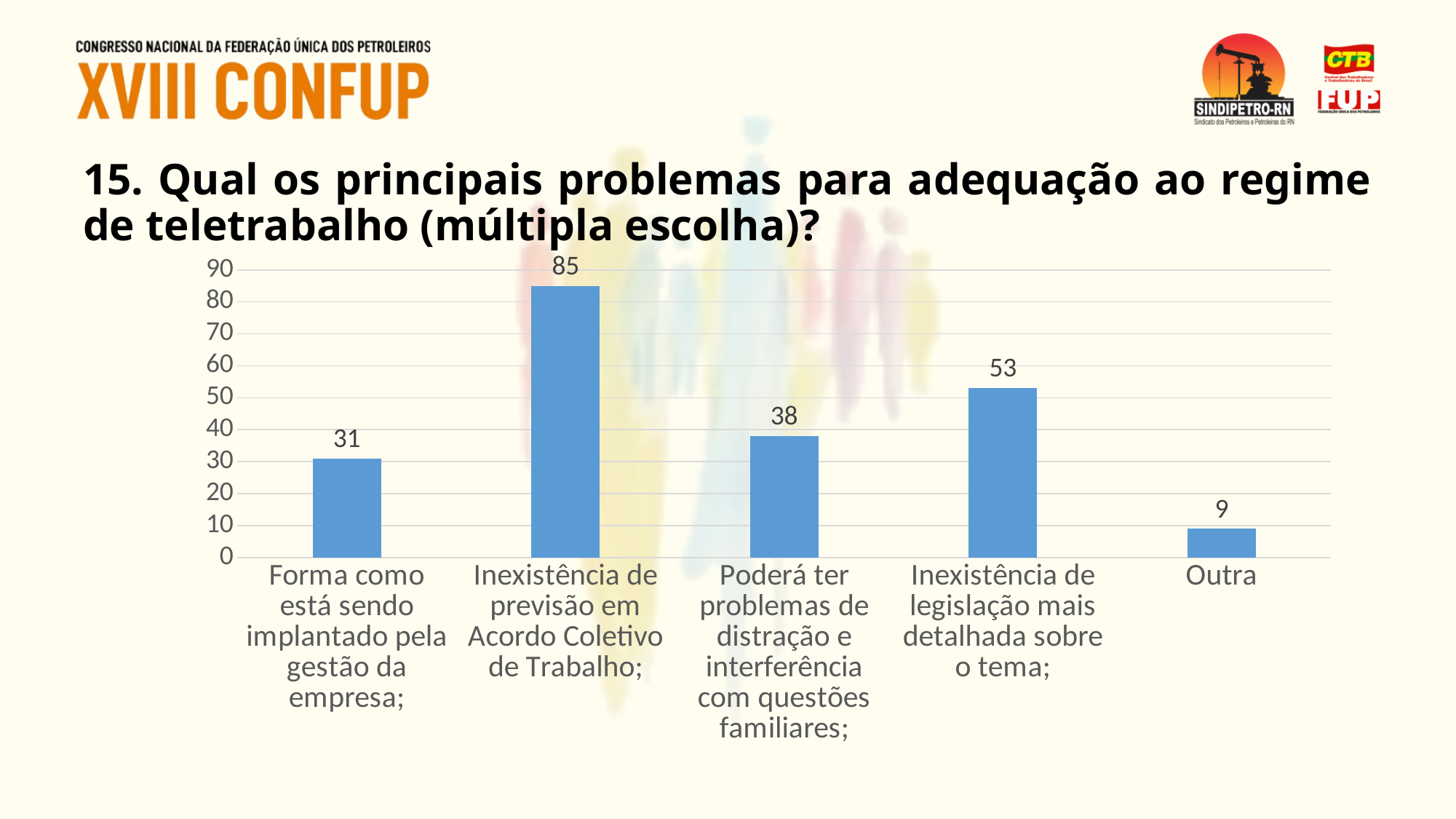
What kind of chart is shown on the slide? Bar chart How many categories are shown in the chart? 5 What is the value for "Inexistência de legislação mais detalhada sobre o tema"? 53 Which category has the lowest value? Outra What is the value for "Outra"? 9 Which category has the highest value? Inexistência de previsão em Acordo Coletivo de Trabalho What is the value for "Inexistência de previsão em Acordo Coletivo de Trabalho"? 85 What is the value for "Poderá ter problemas de distração e interferência com questões familiares"? 38 Which is larger: the value for "Forma como está sendo implantado pela gestão da empresa" or the value for "Poderá ter problemas de distração e interferência com questões familiares"? Poderá ter problemas de distração e interferência com questões familiares What is the difference between the values for "Forma como está sendo implantado pela gestão da empresa" and "Outra"? 22 Is the value for "Inexistência de legislação mais detalhada sobre o tema" greater or less than 50? greater What is the difference between the values for "Inexistência de previsão em Acordo Coletivo de Trabalho" and "Inexistência de legislação mais detalhada sobre o tema"? 32